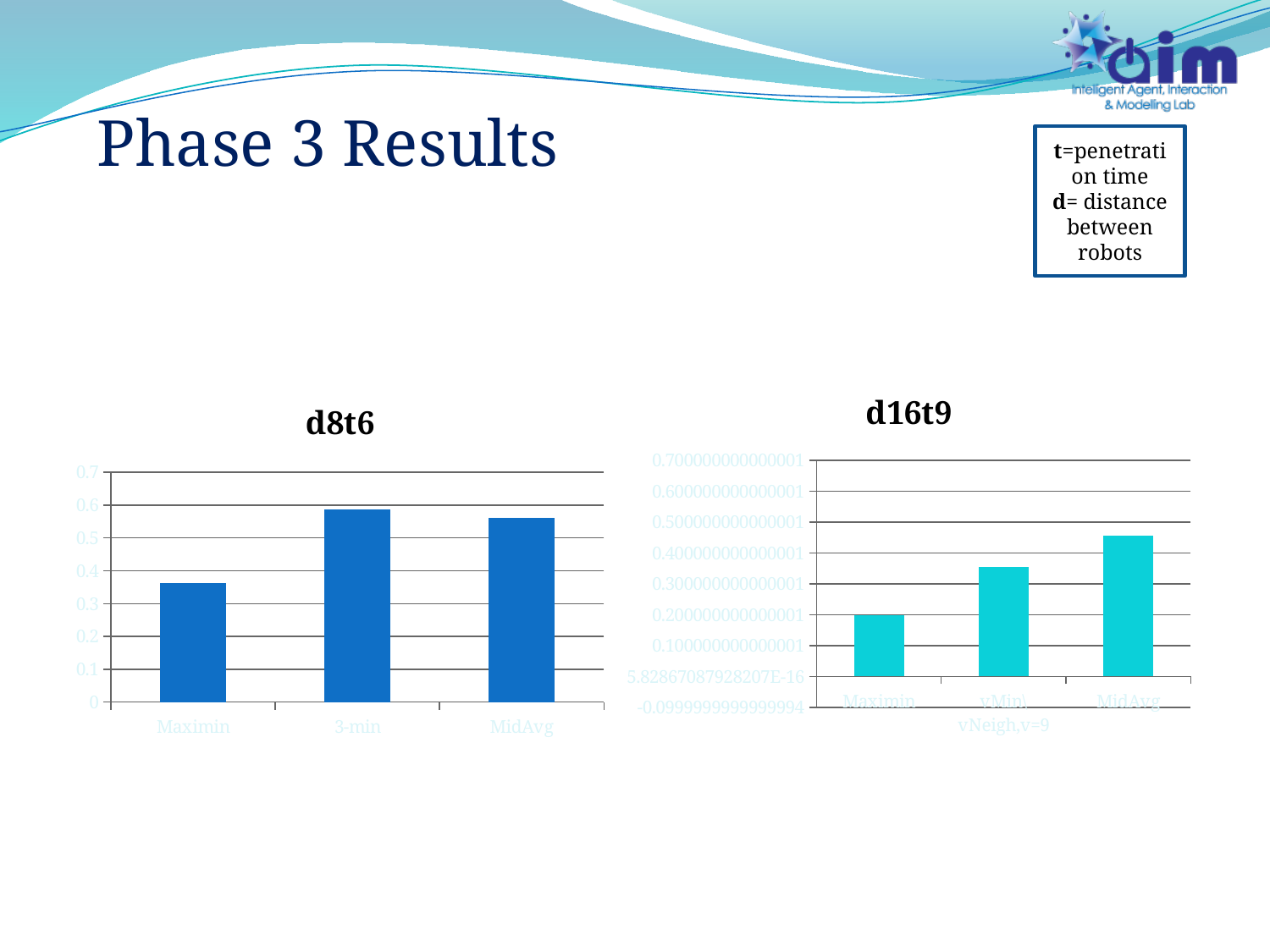
What type of chart is the d8t6 chart? bar chart What type of chart is the d16t9 chart? bar chart How many bars are plotted in the d16t9 chart? 3 In the d8t6 chart, which is larger, the value for Maximin or the value for 3-min? 3-min In the d8t6 chart, is the value for Maximin greater or less than 0.4? less In the d16t9 chart, which category has the highest value? MidAvg In the d8t6 chart, is the value for 3-min greater or less than 0.5? greater In the d8t6 chart, is the value for MidAvg greater or less than 0.6? less How many categories are shown on the x axis of the d8t6 chart? 3 What is the title of the chart on the right side of the slide? d16t9 In the d8t6 chart, which category has the lowest value? Maximin In the d16t9 chart, do the values rise or fall from left to right along the x axis? rise